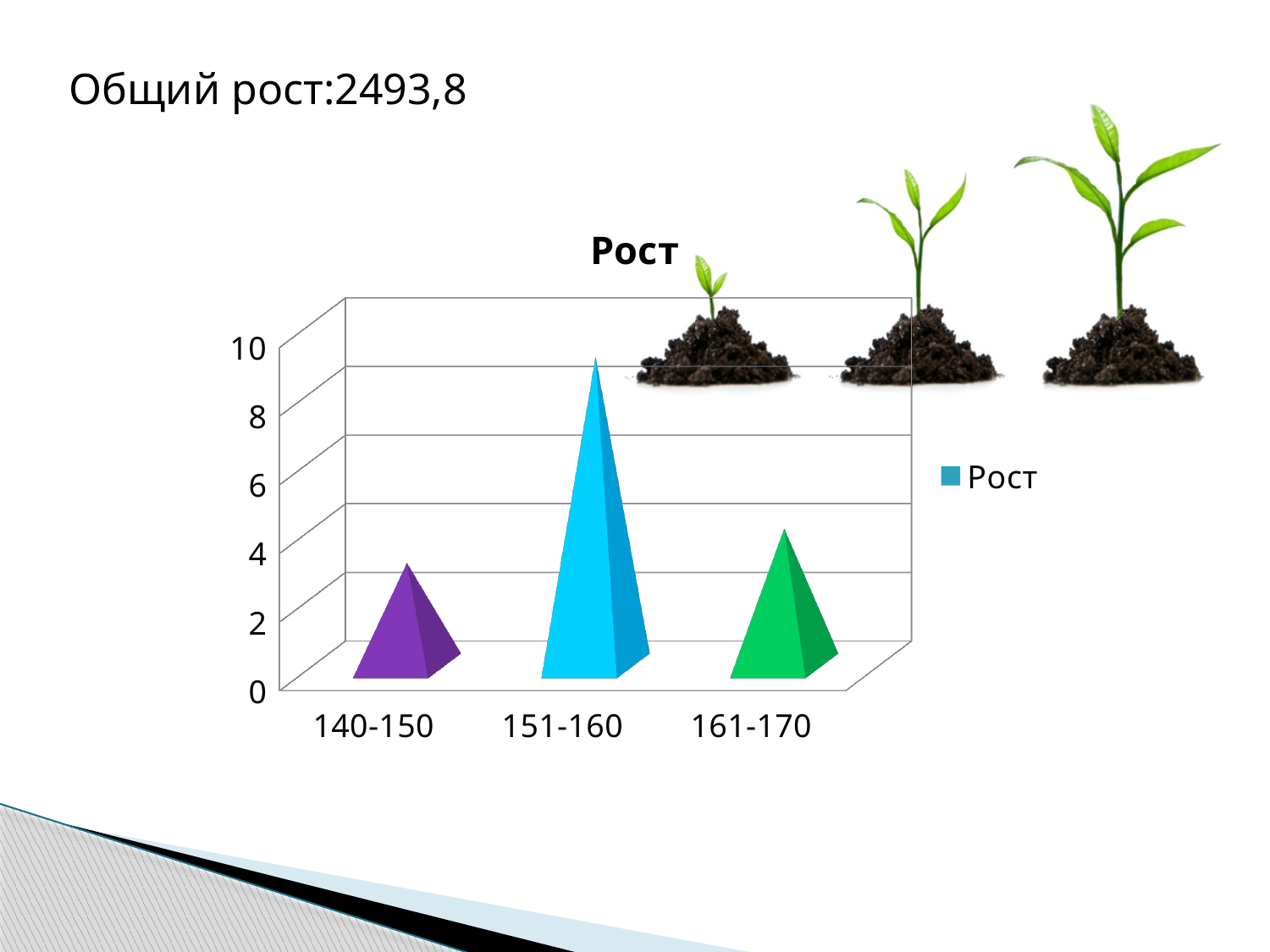
What is the title of the chart? Рост Which is larger, the value for 151-160 or the value for 161-170? 151-160 Which category has the lowest value in the chart? 140-150 What is the name of the series shown in the chart legend? Рост Is the value for 140-150 greater or less than 6? less How many categories are shown on the x axis of the chart? 3 How many series does the chart legend list? 1 Is the value for 161-170 greater or less than 2? greater Which category has the highest value in the chart? 151-160 What kind of chart is shown on the slide? bar chart Is the value for 161-170 greater or less than 6? less